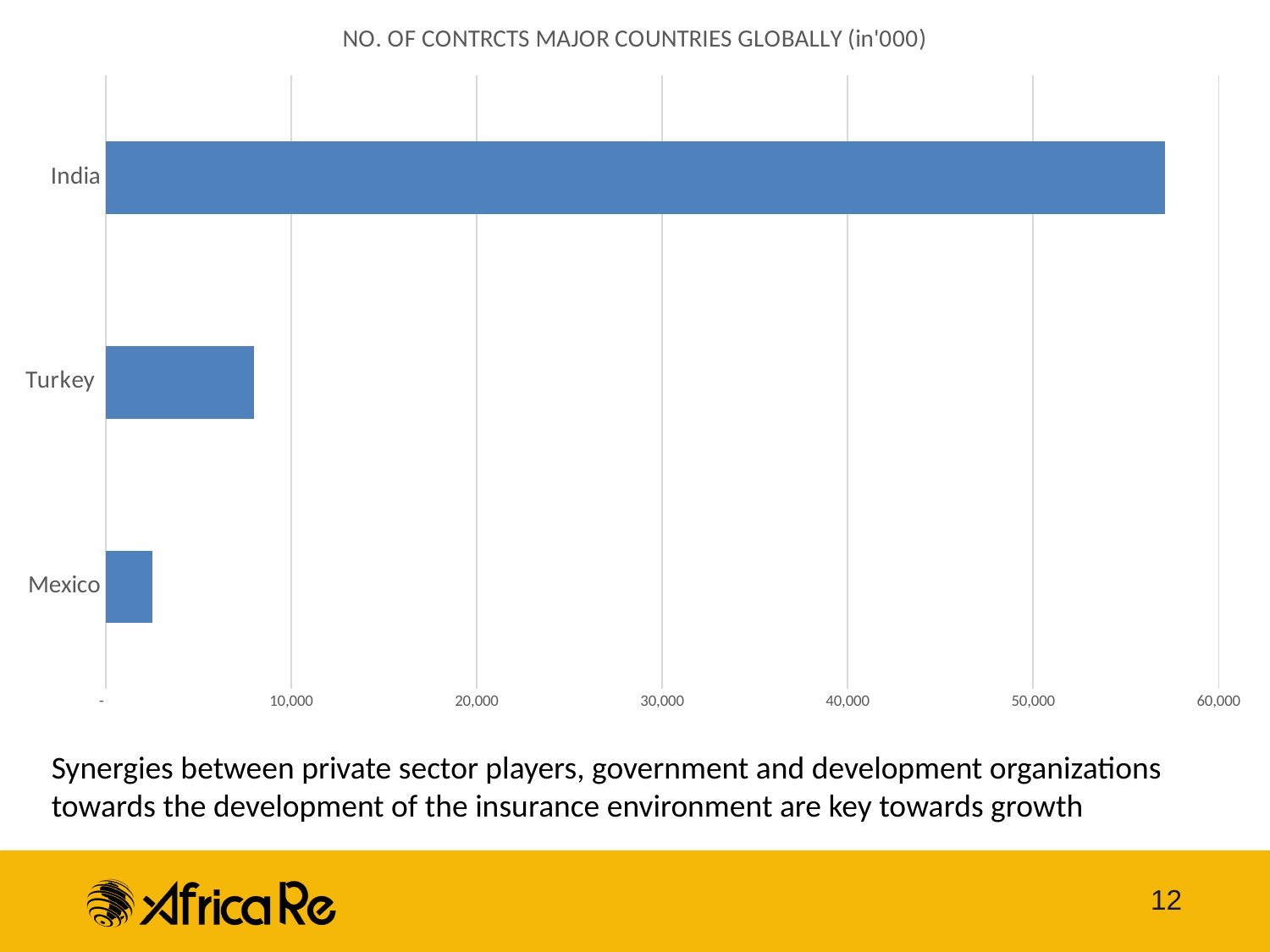
Which has more contracts, India or Turkey? India What is the maximum value shown on the horizontal axis? 60,000 Is the value for India greater or less than 50,000? greater How many countries are shown in the chart? 3 What kind of chart is shown on the slide? bar chart What is the title of the chart? NO. OF CONTRCTS MAJOR COUNTRIES GLOBALLY (in'000) Is the value for Turkey greater or less than 10,000? less Which has more contracts, Turkey or Mexico? Turkey Is the value for Mexico greater or less than 10,000? less Which country has the highest number of contracts? India Which country has the lowest number of contracts? Mexico